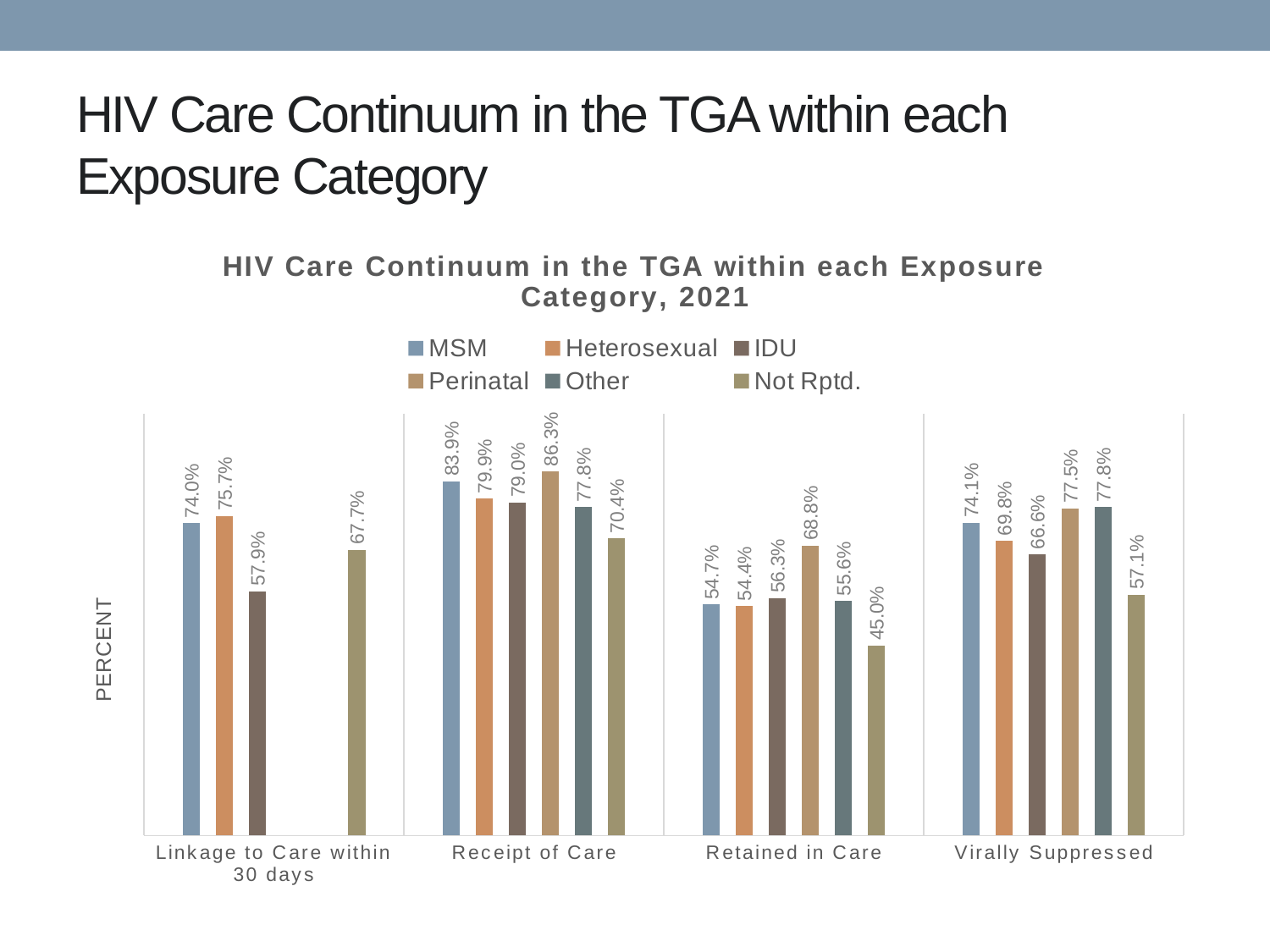
What kind of chart is shown on the slide? Bar chart What is the label on the vertical axis of the chart? PERCENT What is the Not Rptd. value for Retained in Care? 45.0% How many care continuum stages are shown on the x axis? 4 What is the IDU value for Linkage to Care within 30 days? 57.9% Which exposure category has the highest value for Receipt of Care? Perinatal Which is larger for Linkage to Care within 30 days: the MSM value or the Not Rptd. value? MSM What is the Perinatal value for Virally Suppressed? 77.5% What is the MSM value for Receipt of Care? 83.9% Which exposure category has the lowest value for Virally Suppressed? Not Rptd. How many series does the legend list? 6 What is the difference between the Perinatal and Not Rptd. values for Retained in Care? 23.8%